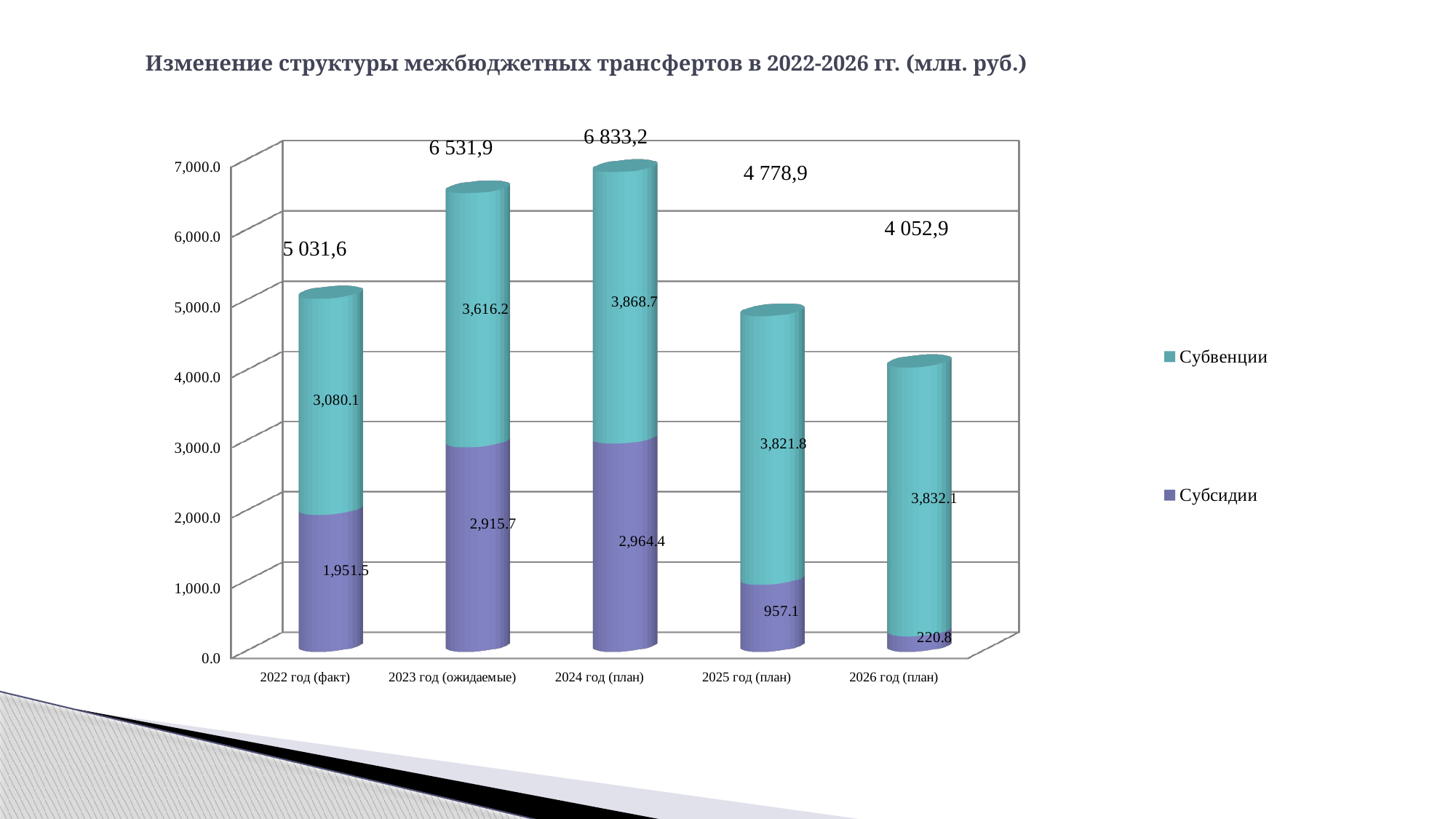
What kind of chart is shown on the slide? Stacked bar chart Which year has the highest value for Субвенции? 2024 год (план) What is the total of the stacked bar for 2024 год (план)? 6 833,2 How many years are shown on the x axis? 5 What is the difference between Субвенции and Субсидии for 2023 год (ожидаемые)? 700.5 What is the value of Субсидии for 2026 год (план)? 220.8 Which year has the lowest value for Субсидии? 2026 год (план) Which is larger for 2025 год (план): Субвенции or Субсидии? Субвенции Which colour represents Субсидии in the chart? Purple How many series does the legend list? 2 What is the value of Субсидии for 2022 год (факт)? 1,951.5 What is the value of Субвенции for 2025 год (план)? 3,821.8